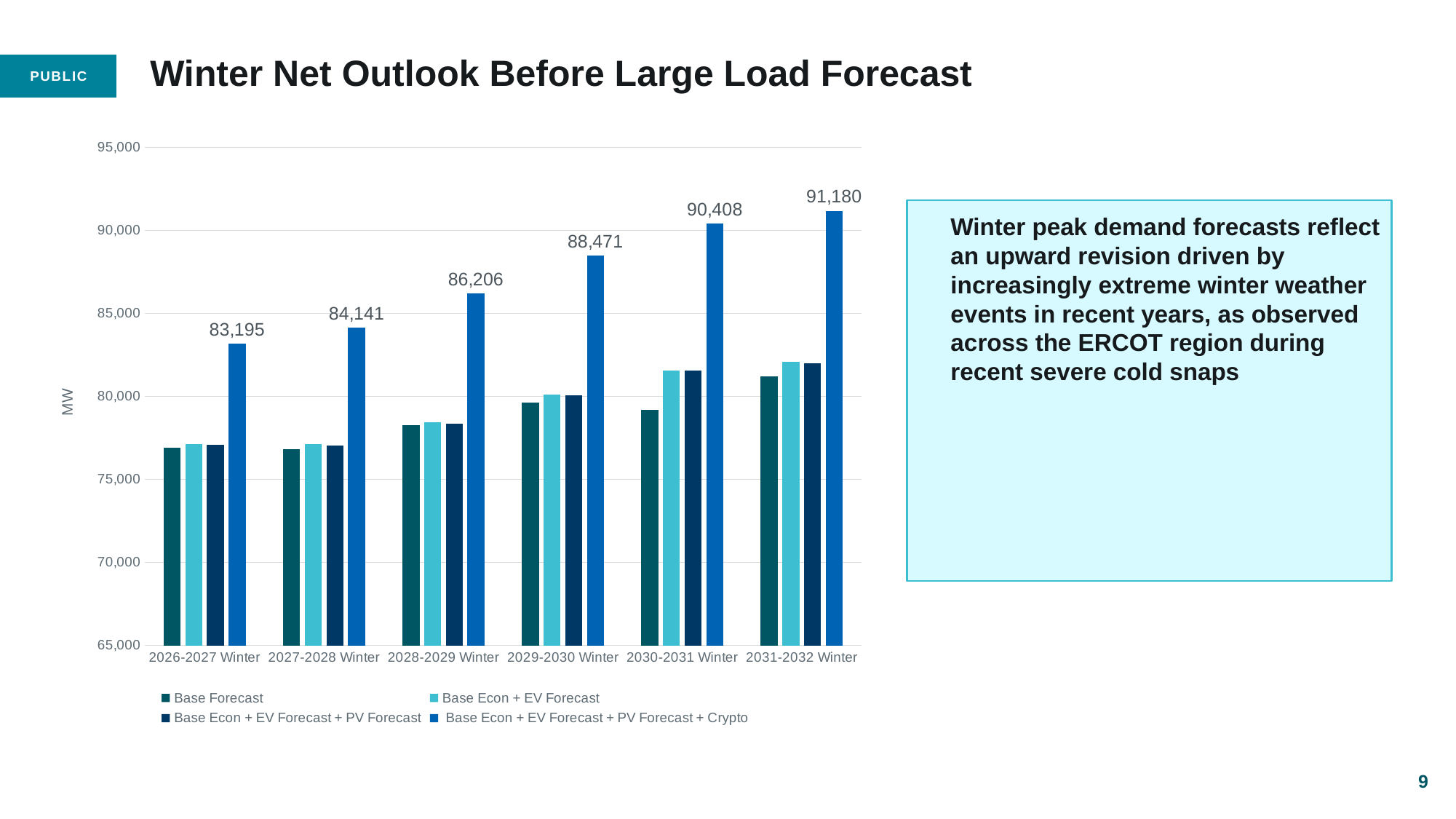
What is the difference between the Base Econ + EV Forecast + PV Forecast + Crypto values for 2030-2031 Winter and 2029-2030 Winter? 1,937 What is the value of the Base Econ + EV Forecast + PV Forecast + Crypto series for 2029-2030 Winter? 88,471 What is the difference between the Base Econ + EV Forecast + PV Forecast + Crypto values for 2031-2032 Winter and 2026-2027 Winter? 7,985 How many series does the legend list? 4 How many winter periods are shown on the x axis? 6 Is the Base Econ + EV Forecast value for 2031-2032 Winter greater or less than 80,000? greater Is the Base Forecast value for 2026-2027 Winter greater or less than 80,000? less What is the value of the Base Econ + EV Forecast + PV Forecast + Crypto series for 2031-2032 Winter? 91,180 Does the Base Econ + EV Forecast + PV Forecast + Crypto series rise or fall from 2026-2027 Winter to 2031-2032 Winter? rise Which winter has the lowest value for the Base Econ + EV Forecast + PV Forecast + Crypto series? 2026-2027 Winter Which winter has the highest value for the Base Econ + EV Forecast + PV Forecast + Crypto series? 2031-2032 Winter What is the value of the Base Econ + EV Forecast + PV Forecast + Crypto series for 2026-2027 Winter? 83,195